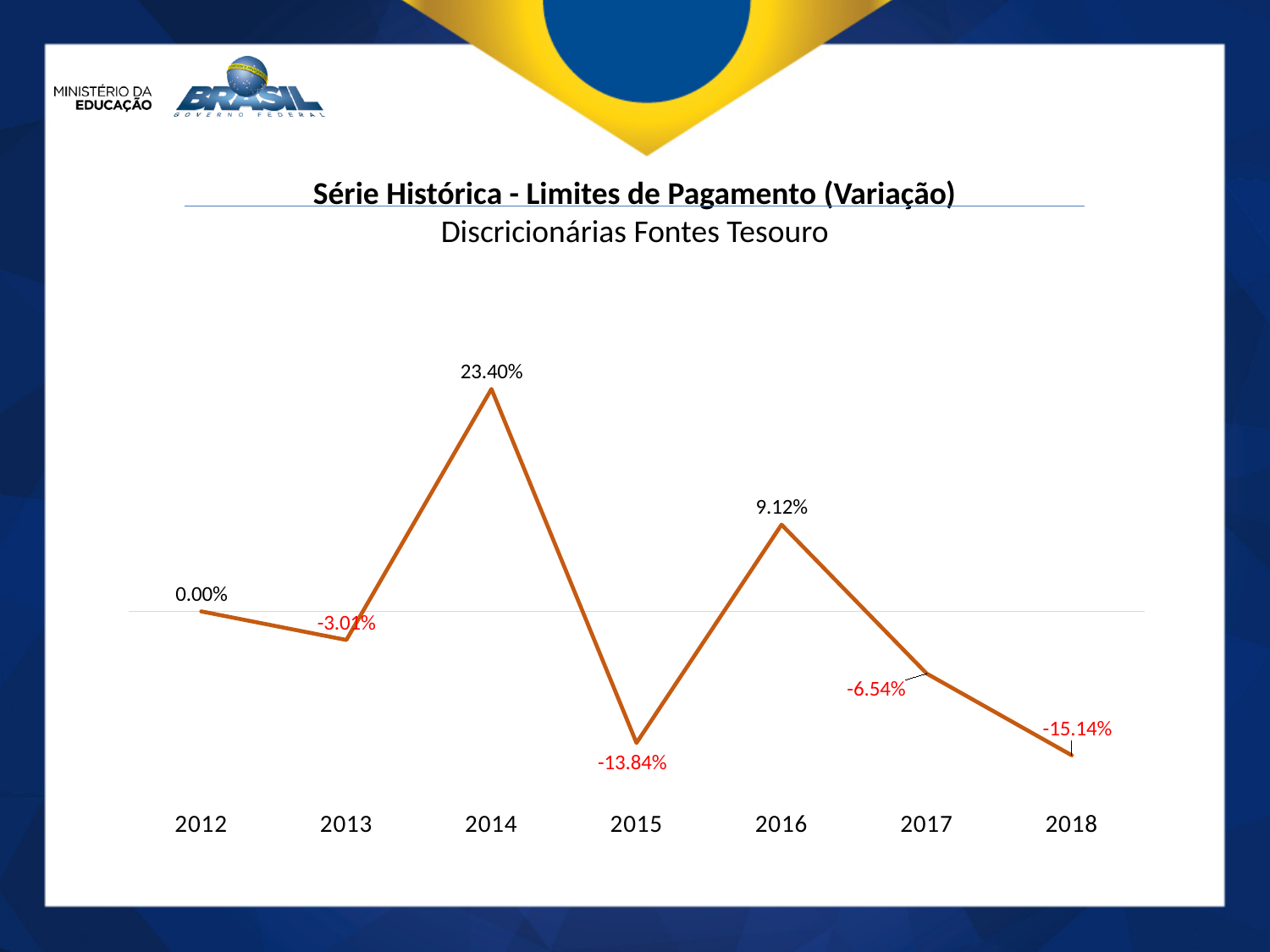
Do the values rise or fall from 2016 to 2018? fall Which year has the highest value? 2014 What is the difference between the values for 2014 and 2016? 14.28 percentage points Which year has the lowest value? 2018 What is the value for 2012? 0.00% What is the value for 2016? 9.12% What is the value for 2018? -15.14% How many years are plotted on the x axis of the chart? 7 What kind of chart is shown on the slide? line chart What is the value for 2017? -6.54% What is the value for 2014? 23.40% What is the value for 2015? -13.84%